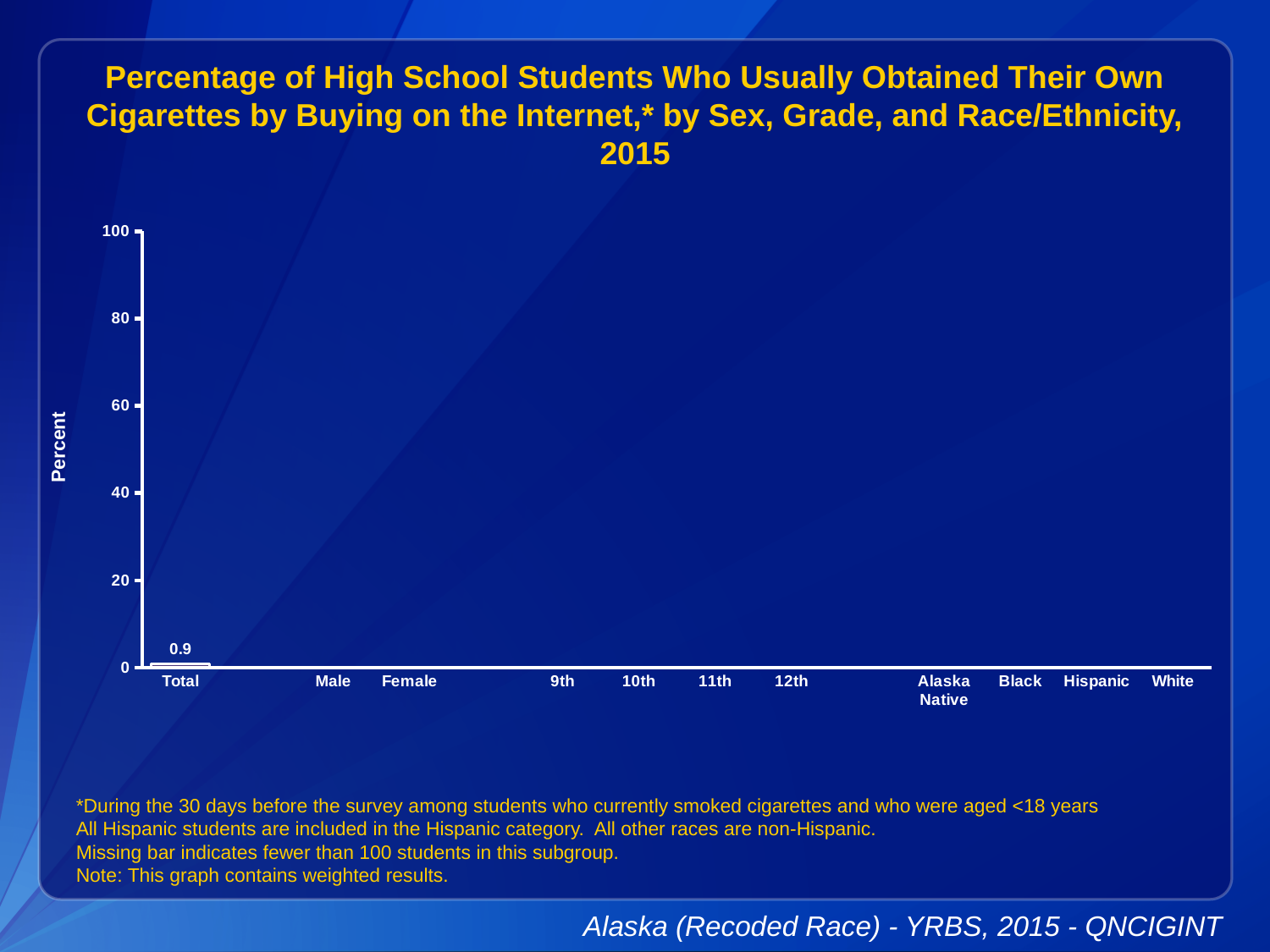
Which category is the only one with a plotted bar? Total How many bars are actually plotted on the chart? 1 How many categories are labeled on the x axis? 11 Which category has the highest plotted value? Total What year does the chart title refer to? 2015 What is the value for Total? 0.9 What kind of chart is shown on the slide? bar chart What is the label of the y axis? Percent Is the value for Total greater or less than 20? less